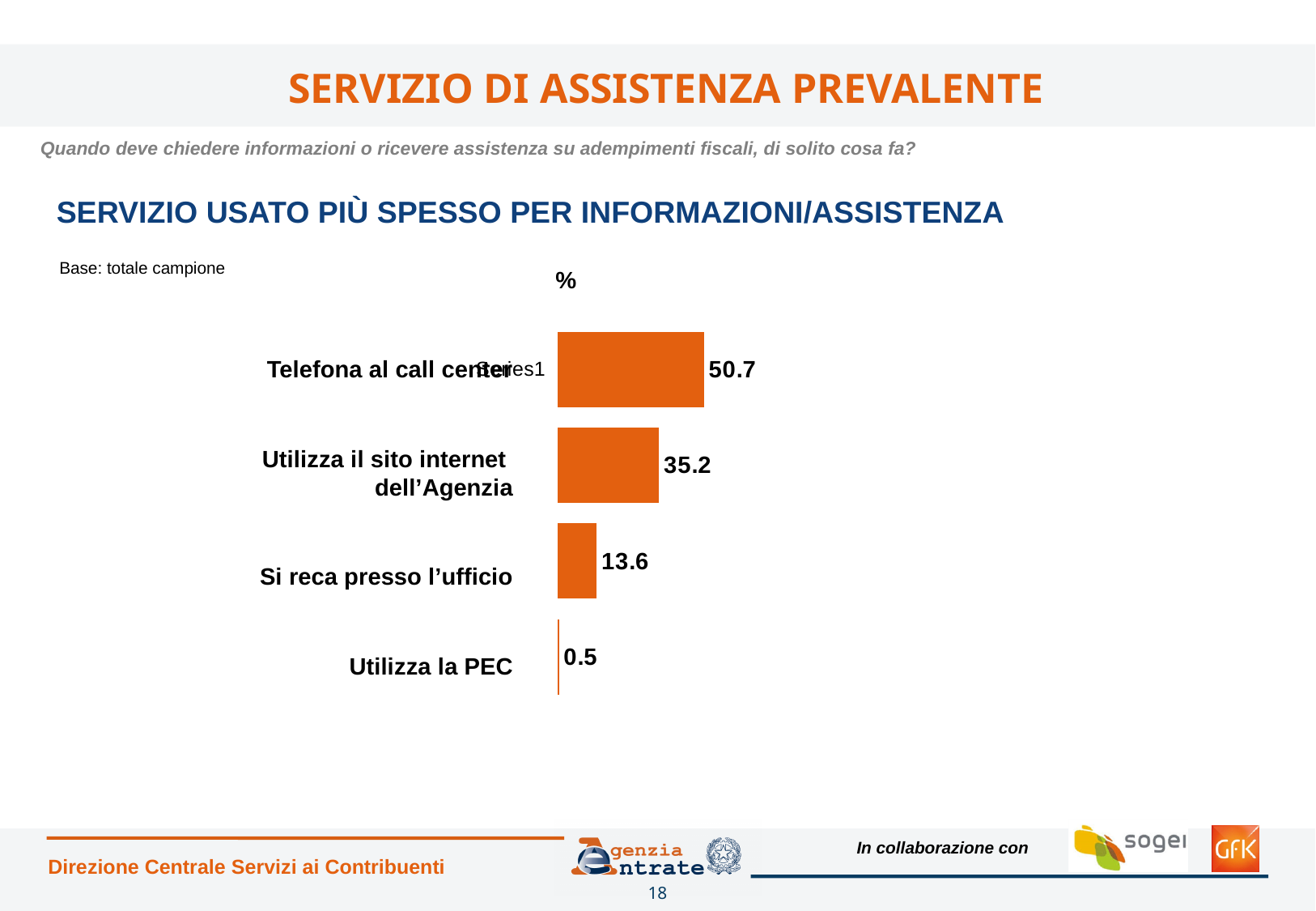
What kind of chart is shown on the slide? Bar chart What is the value for "Si reca presso l'ufficio"? 13.6 What is the value for "Telefona al call center"? 50.7 What is the title of the chart? SERVIZIO USATO PIÙ SPESSO PER INFORMAZIONI/ASSISTENZA What is the difference between the values for "Telefona al call center" and "Utilizza il sito internet dell'Agenzia"? 15.5 What is the difference between the values for "Utilizza il sito internet dell'Agenzia" and "Si reca presso l'ufficio"? 21.6 Which category has the lowest value? Utilizza la PEC Which category has the highest value? Telefona al call center How many categories are shown in the chart? 4 What is the value for "Utilizza la PEC"? 0.5 What is the value for "Utilizza il sito internet dell'Agenzia"? 35.2 Which is larger, the value for "Si reca presso l'ufficio" or the value for "Utilizza la PEC"? Si reca presso l'ufficio